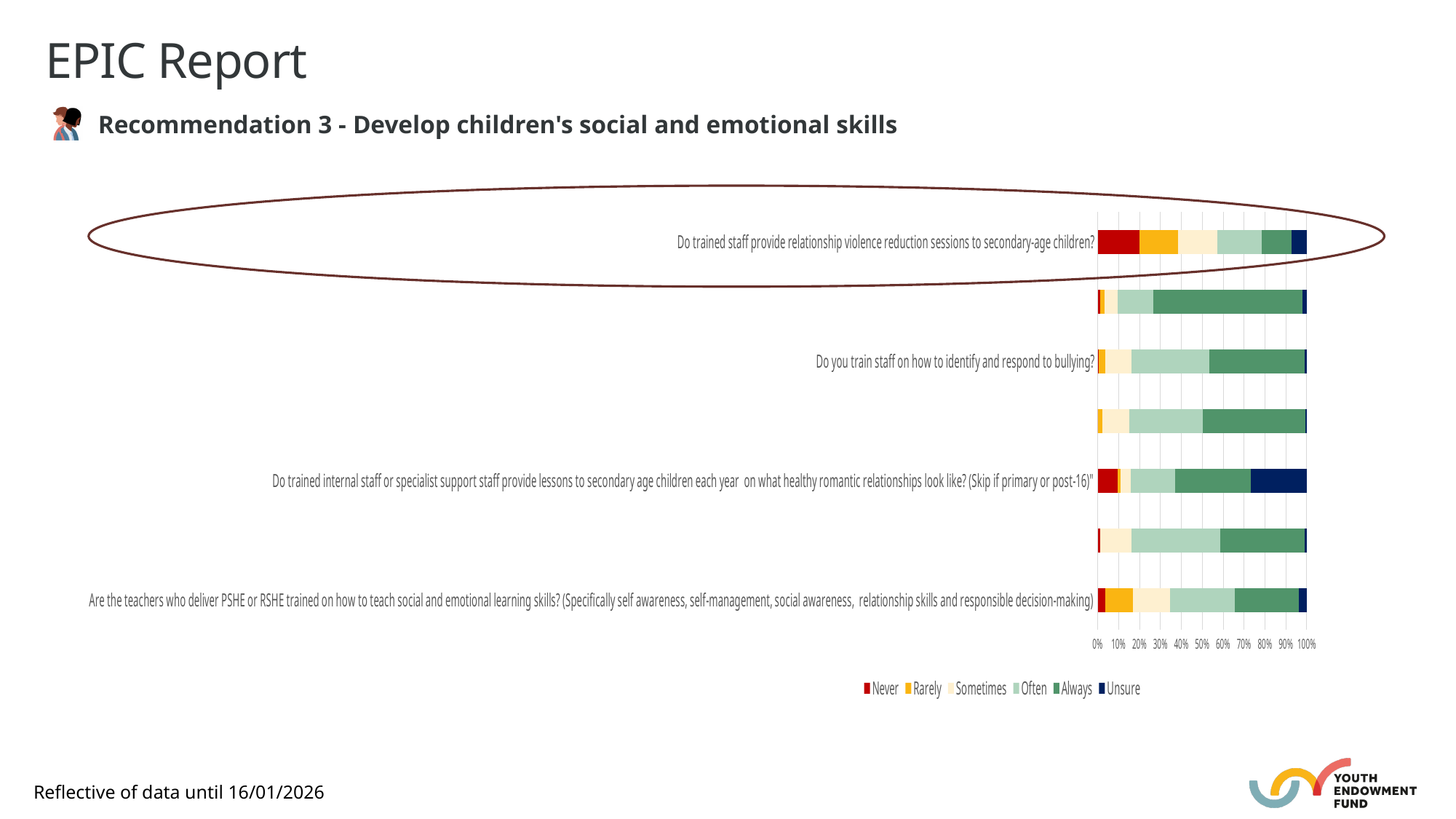
Is the Always segment for the question about teachers who deliver PSHE or RSHE being trained on social and emotional learning skills greater or less than 20%? greater What kind of chart is shown on the slide? Stacked bar chart Is the Unsure segment for the question about lessons on what healthy romantic relationships look like greater or less than 10%? greater Which question has the largest Unsure segment? Do trained internal staff or specialist support staff provide lessons to secondary age children each year on what healthy romantic relationships look like? (Skip if primary or post-16) Is the Never segment for 'Do trained staff provide relationship violence reduction sessions to secondary-age children?' greater or less than 10%? greater What are the entries in the chart legend? Never, Rarely, Sometimes, Often, Always, Unsure How many bars are plotted in the chart? 7 Which question has the largest Never segment? Do trained staff provide relationship violence reduction sessions to secondary-age children? How many series does the chart legend list? 6 Which has the larger Always segment: the bullying training question or the relationship violence reduction sessions question? Do you train staff on how to identify and respond to bullying?